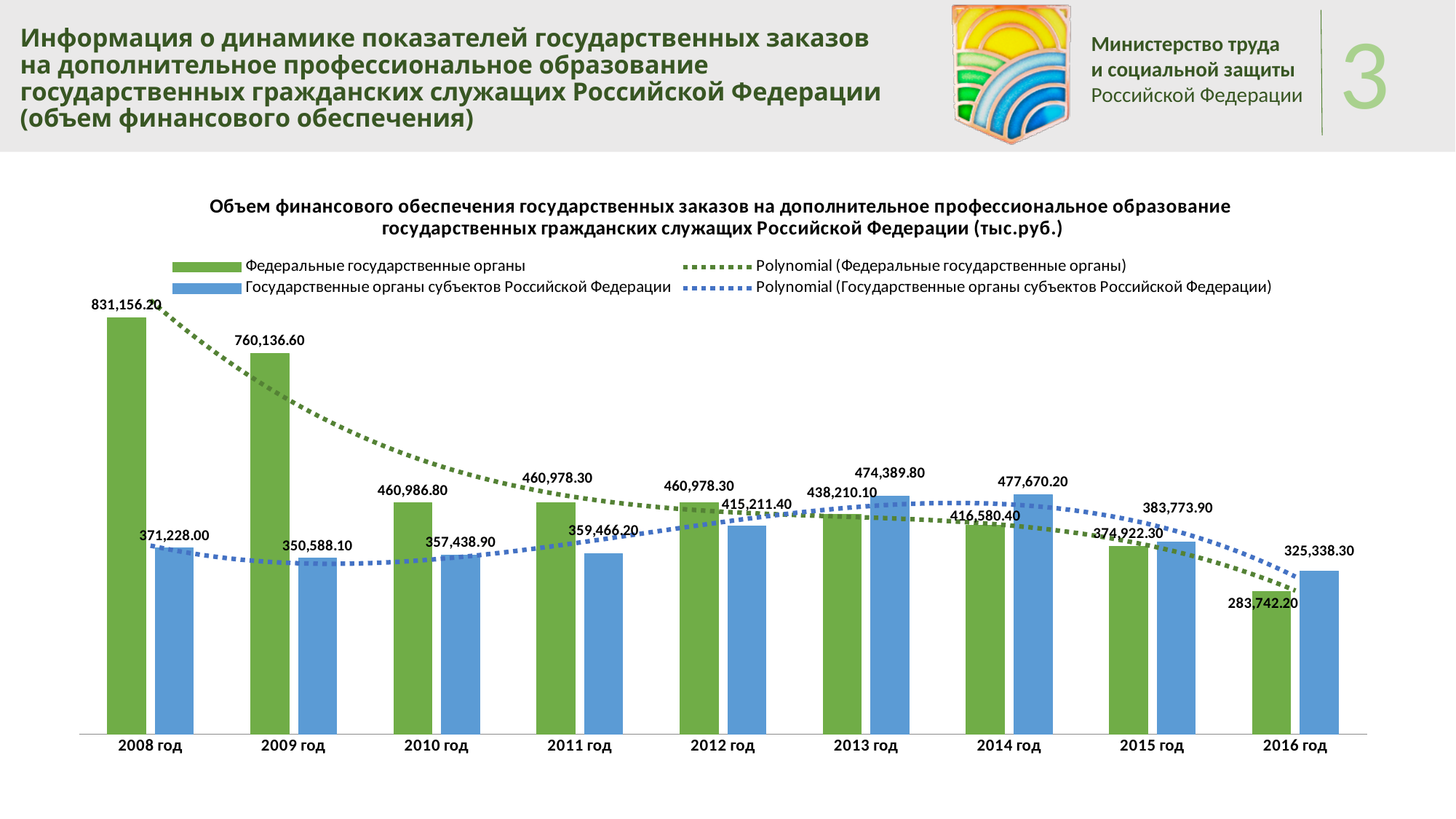
How many years are shown on the x axis? 9 What is the difference between Федеральные государственные органы and Государственные органы субъектов Российской Федерации in 2008 год? 459,928.20 What is the value for Федеральные государственные органы in 2016 год? 283,742.20 Do the values for Федеральные государственные органы rise or fall from 2008 год to 2016 год? Fall Which series has the larger value in 2013 год? Государственные органы субъектов Российской Федерации In which year is the value for Государственные органы субъектов Российской Федерации lowest? 2016 год What kind of chart is shown on the slide? Bar chart By how much does Государственные органы субъектов Российской Федерации exceed Федеральные государственные органы in 2014 год? 61,089.80 What is the value for Государственные органы субъектов Российской Федерации in 2014 год? 477,670.20 What is the value for Федеральные государственные органы in 2008 год? 831,156.20 How many entries does the legend list? 4 In which year is the value for Федеральные государственные органы highest? 2008 год